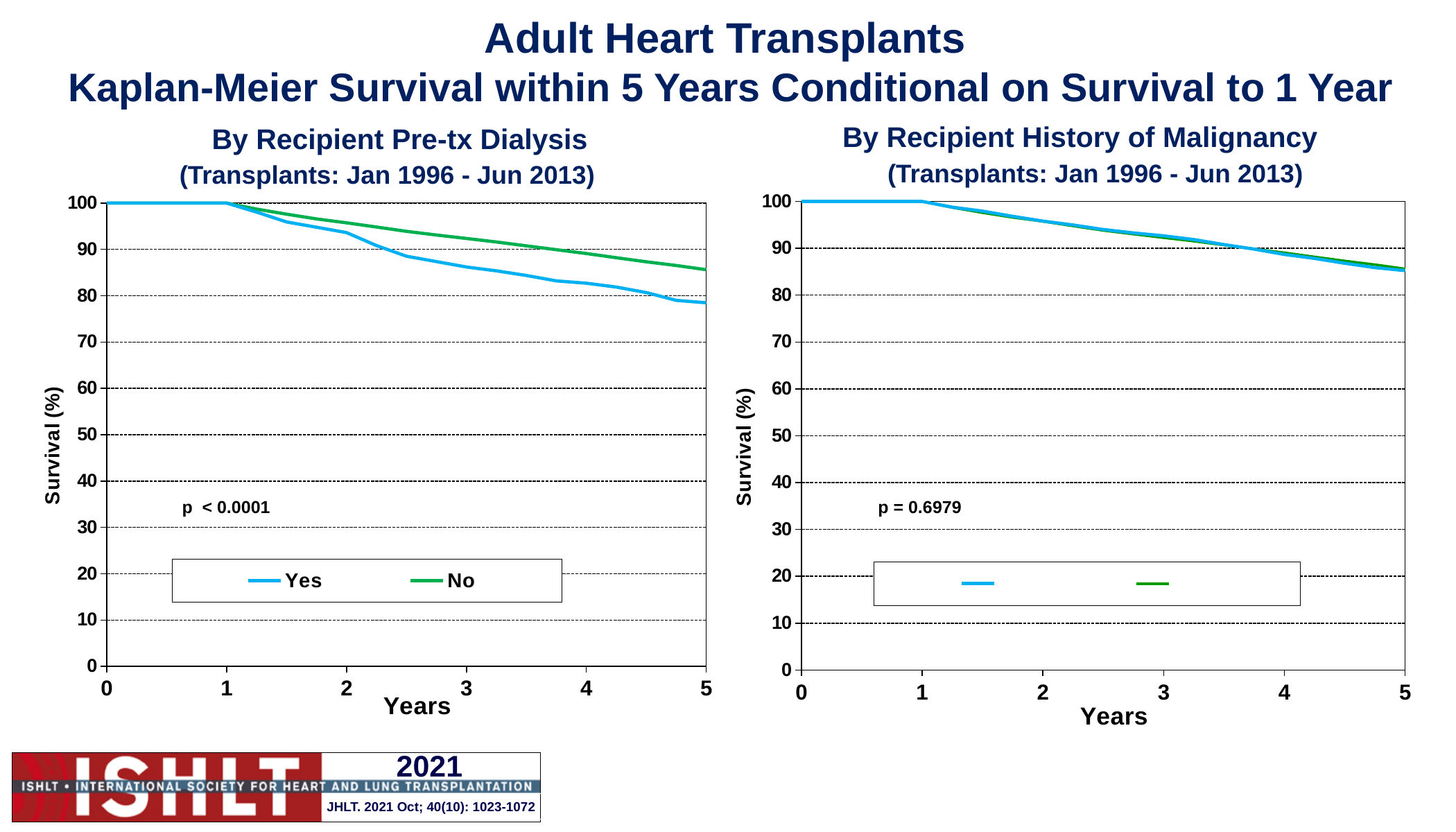
In the left chart, 'By Recipient Pre-tx Dialysis', is the survival for the Yes series at 5 years greater or less than 90? less What p-value is printed on the left chart, 'By Recipient Pre-tx Dialysis'? p < 0.0001 In the left chart, 'By Recipient Pre-tx Dialysis', which series has higher survival at 3 years, Yes or No? No How many series does the legend of the left chart, 'By Recipient Pre-tx Dialysis', list? 2 In the left chart, 'By Recipient Pre-tx Dialysis', is the survival for the No series at 5 years greater or less than 80? greater In the right chart, 'By Recipient History of Malignancy', is the survival of either series at 5 years greater or less than 80? greater In the left chart, 'By Recipient Pre-tx Dialysis', does survival rise or fall as years increase after year 1? Fall In the left chart, 'By Recipient Pre-tx Dialysis', which series has higher survival at 5 years, Yes or No? No What kind of chart is the left chart, 'By Recipient Pre-tx Dialysis'? Line chart What p-value is printed on the right chart, 'By Recipient History of Malignancy'? p = 0.6979